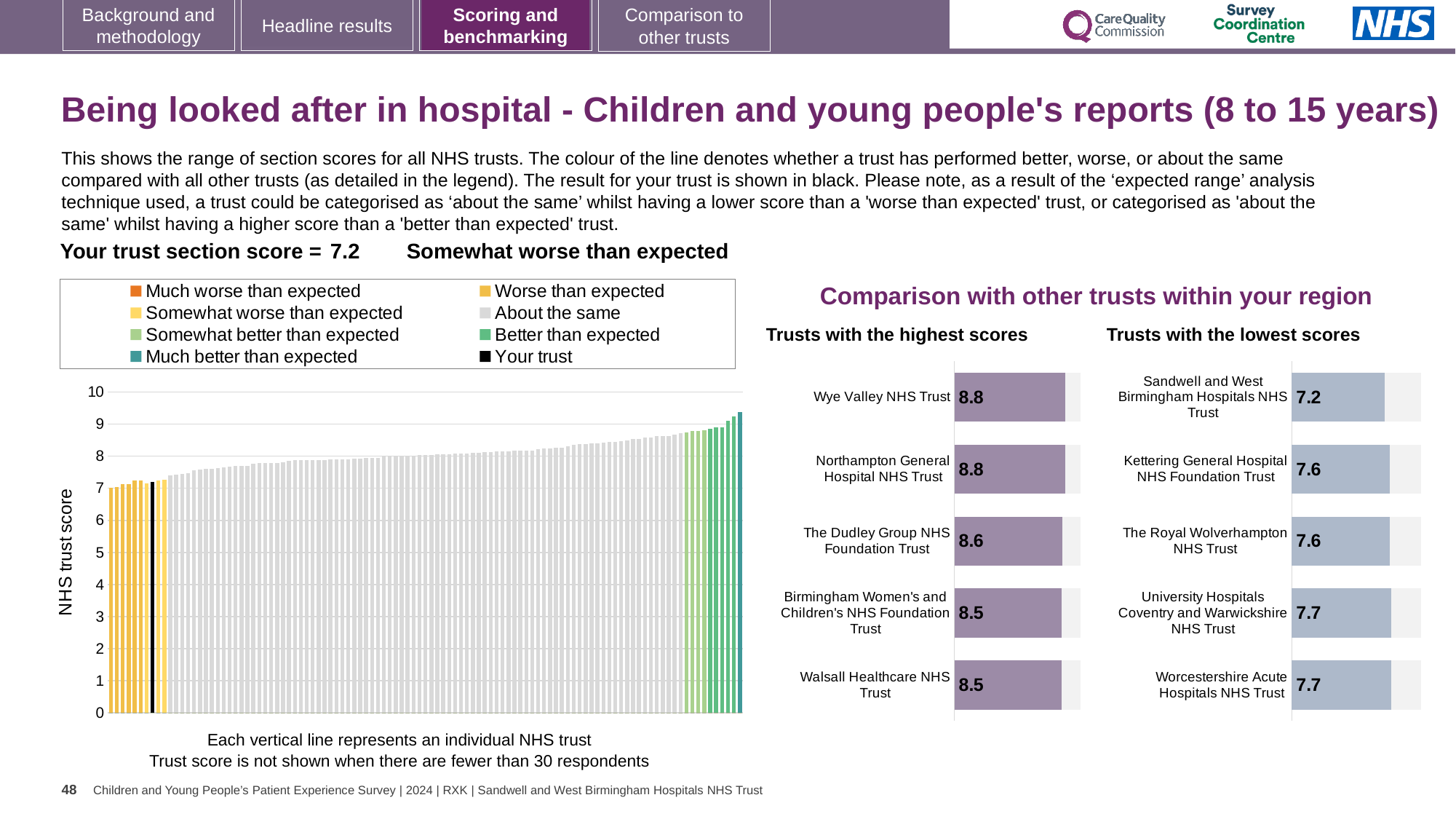
In the large 'NHS trust score' chart on the left, do the bar values rise or fall from left to right? Rise In the 'Trusts with the lowest scores' chart, what is the difference between the scores of Worcestershire Acute Hospitals NHS Trust and Sandwell and West Birmingham Hospitals NHS Trust? 0.5 In the 'Trusts with the highest scores' chart, what is the score for Wye Valley NHS Trust? 8.8 In the 'Trusts with the lowest scores' chart, which trust has the lowest score? Sandwell and West Birmingham Hospitals NHS Trust In the large 'NHS trust score' chart on the left, is the value of the black 'Your trust' bar greater or less than 8? less In the 'Trusts with the highest scores' chart, what is the score for The Dudley Group NHS Foundation Trust? 8.6 In the 'Trusts with the lowest scores' chart, which has the larger score: University Hospitals Coventry and Warwickshire NHS Trust or Sandwell and West Birmingham Hospitals NHS Trust? University Hospitals Coventry and Warwickshire NHS Trust How many trusts are listed in the 'Trusts with the highest scores' chart? 5 What kind of chart is the large chart on the left with the 'NHS trust score' axis? Bar chart In the 'Trusts with the lowest scores' chart, what is the score for Kettering General Hospital NHS Foundation Trust? 7.6 In the 'Trusts with the highest scores' chart, what is the difference between the scores of Wye Valley NHS Trust and Walsall Healthcare NHS Trust? 0.3 How many entries does the legend of the large 'NHS trust score' chart list? 8